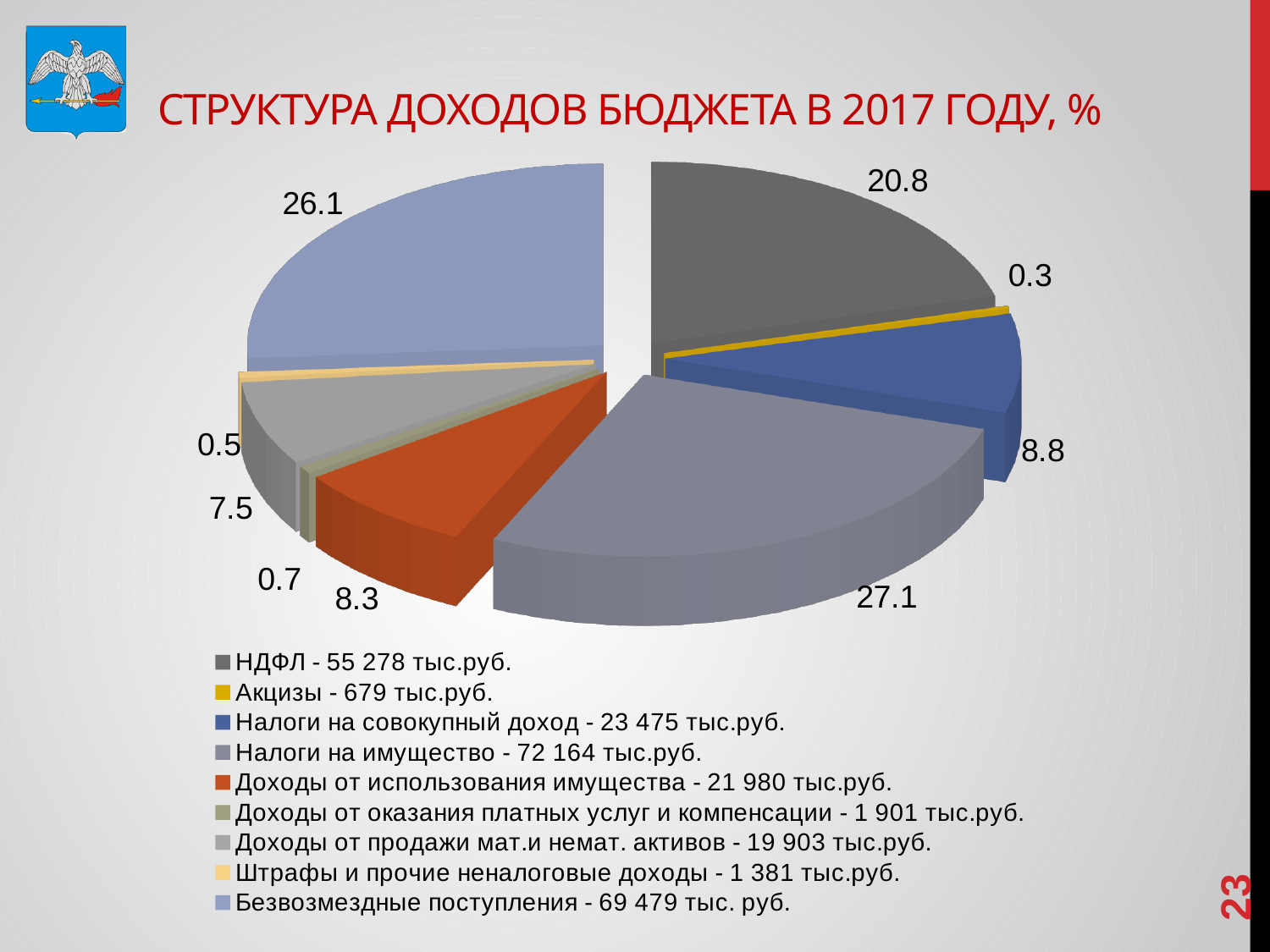
Which category has the largest share of the pie? Налоги на имущество Which is larger, the share for Налоги на совокупный доход or the share for Доходы от использования имущества? Налоги на совокупный доход Which category has the smallest share of the pie? Акцизы What percentage share is shown for НДФЛ? 20.8 What is the difference between the shares of Налоги на имущество and Безвозмездные поступления? 1.0 What percentage share is shown for Безвозмездные поступления? 26.1 What percentage share is shown for Налоги на имущество? 27.1 According to the legend, what amount in тыс.руб. corresponds to Налоги на имущество? 72 164 тыс.руб. What kind of chart is shown on the slide? pie chart What percentage share is shown for Акцизы? 0.3 What is the title of the chart? СТРУКТУРА ДОХОДОВ БЮДЖЕТА В 2017 ГОДУ, % How many slices does the pie chart have? 9